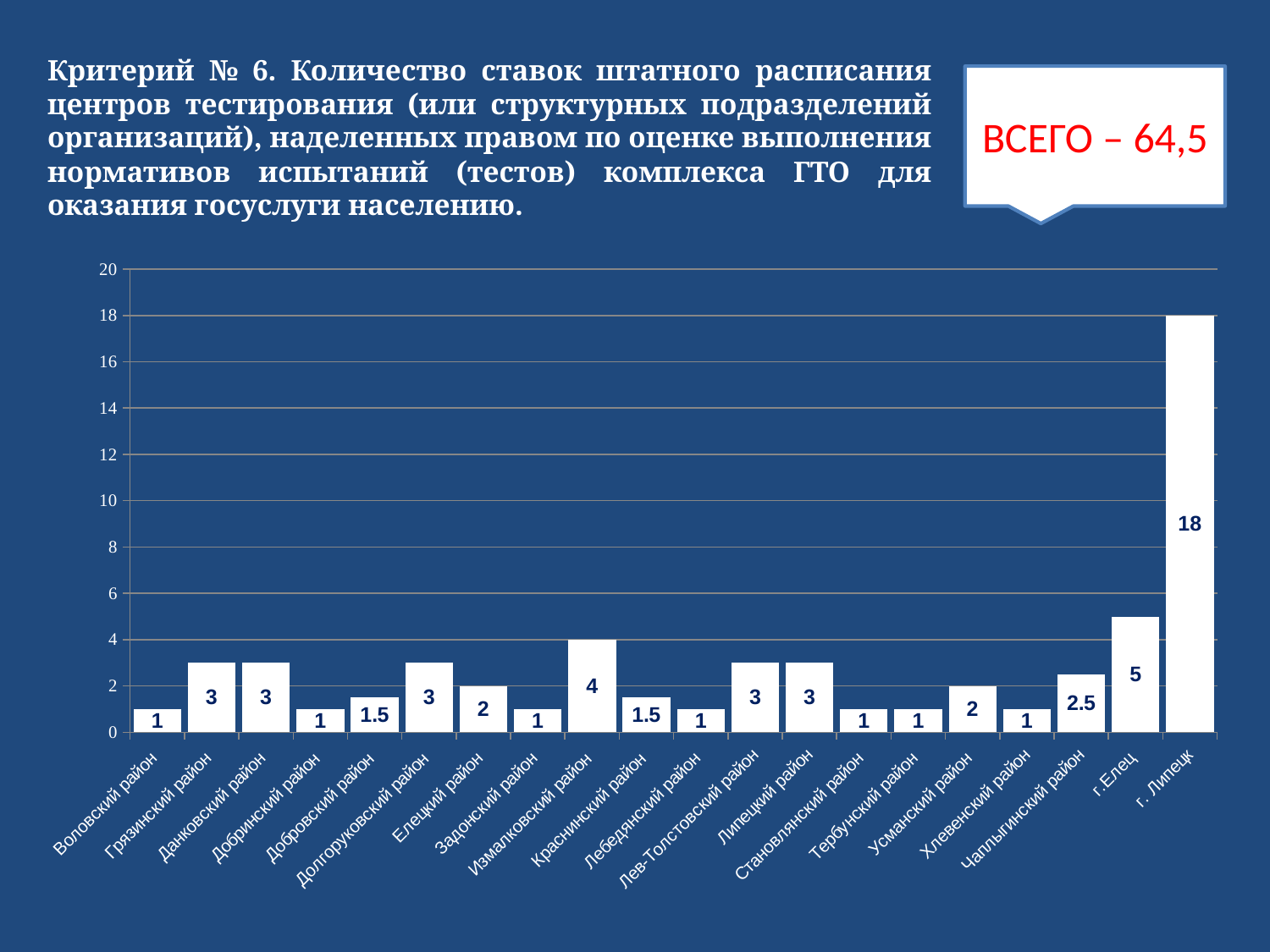
Which is larger, the value for Измалковский район or the value for Елецкий район? Измалковский район What is the value for г. Липецк? 18 How many categories are shown on the x axis of the chart? 20 What type of chart is shown on the slide? bar chart What is the value for г.Елец? 5 Is the value for г. Липецк greater or less than 16? greater What is the difference between the values for г. Липецк and г.Елец? 13 What is the value for Чаплыгинский район? 2.5 Which category has the highest value in the chart? г. Липецк What is the value for Измалковский район? 4 What is the lowest value shown in the chart? 1 What is the value for Добровский район? 1.5